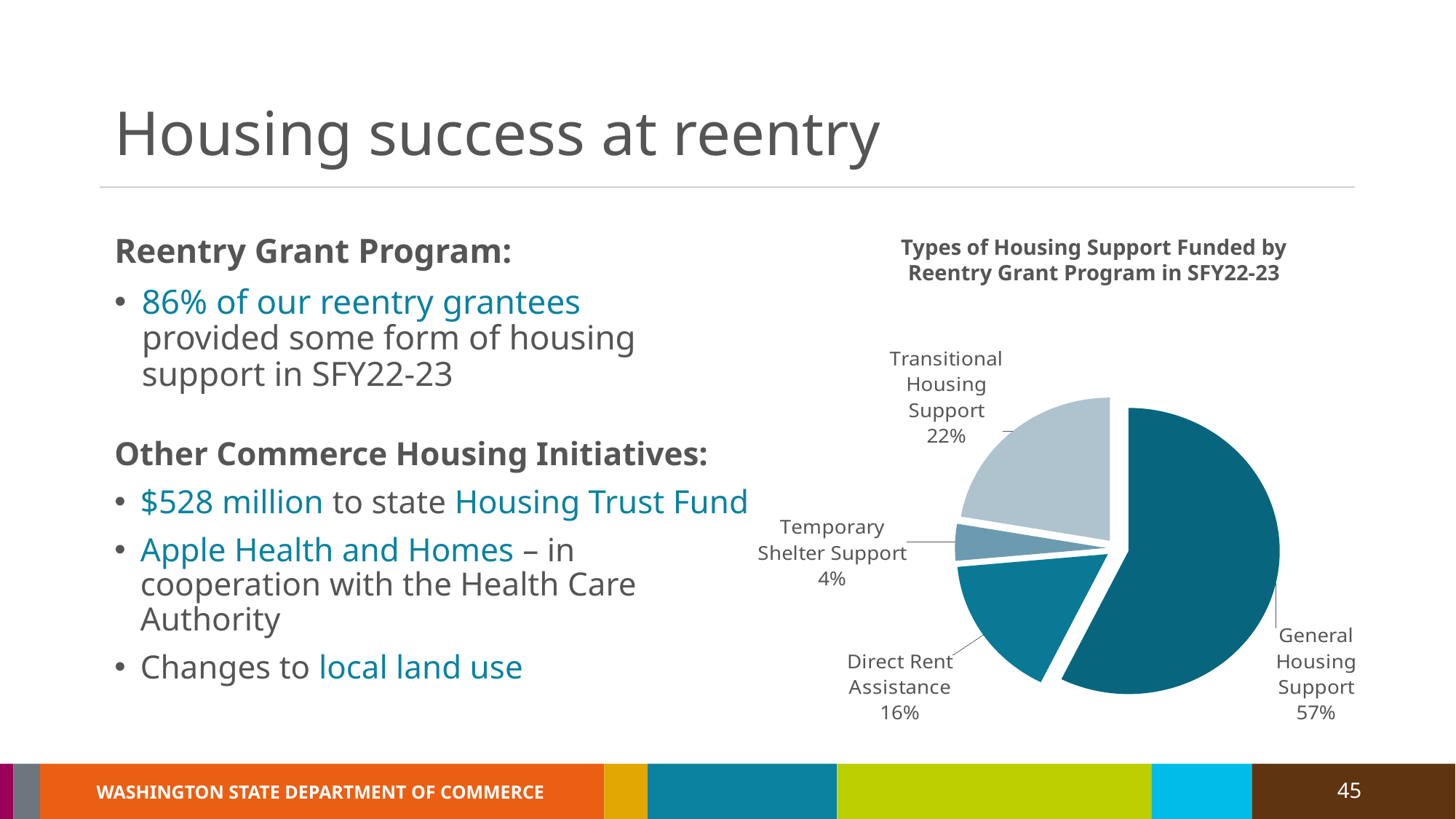
Which category has the smallest slice of the pie? Temporary Shelter Support What share of the pie is Direct Rent Assistance? 16% Which category has the largest slice of the pie? General Housing Support What type of chart is shown on the slide? pie chart How many categories are shown in the pie chart? 4 What share of the pie is Temporary Shelter Support? 4% What is the difference in percentage points between Direct Rent Assistance and Temporary Shelter Support? 12 What is the title of the chart? Types of Housing Support Funded by Reentry Grant Program in SFY22-23 What share of the pie is General Housing Support? 57% Which is larger, Direct Rent Assistance or Transitional Housing Support? Transitional Housing Support What is the difference in percentage points between General Housing Support and Transitional Housing Support? 35